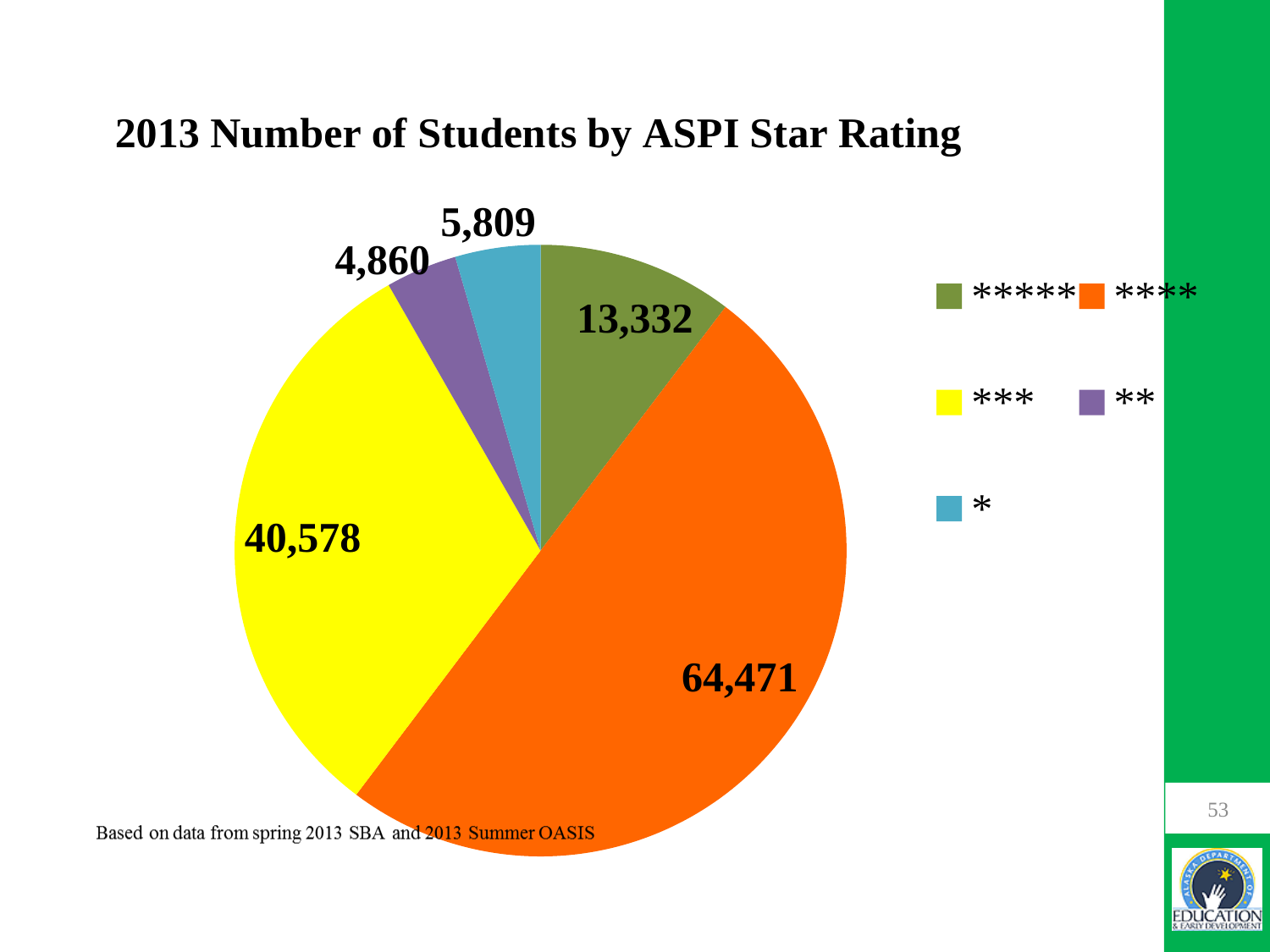
What is the title of the chart? 2013 Number of Students by ASPI Star Rating What type of chart is shown on the slide? Pie chart How many star rating categories are shown in the pie chart? 5 How many students are in the three-star (***) rating category? 40,578 Which star rating category has the smallest number of students? ** (two-star) How many students are in the four-star (****) rating category? 64,471 What is the difference in the number of students between the four-star (****) and three-star (***) categories? 23,893 How many students are in the one-star (*) rating category? 5,809 Which category has more students: one-star (*) or two-star (**)? One-star (*) How many students are in the five-star (*****) rating category? 13,332 How many students are in the two-star (**) rating category? 4,860 Which star rating category has the largest number of students? **** (four-star)